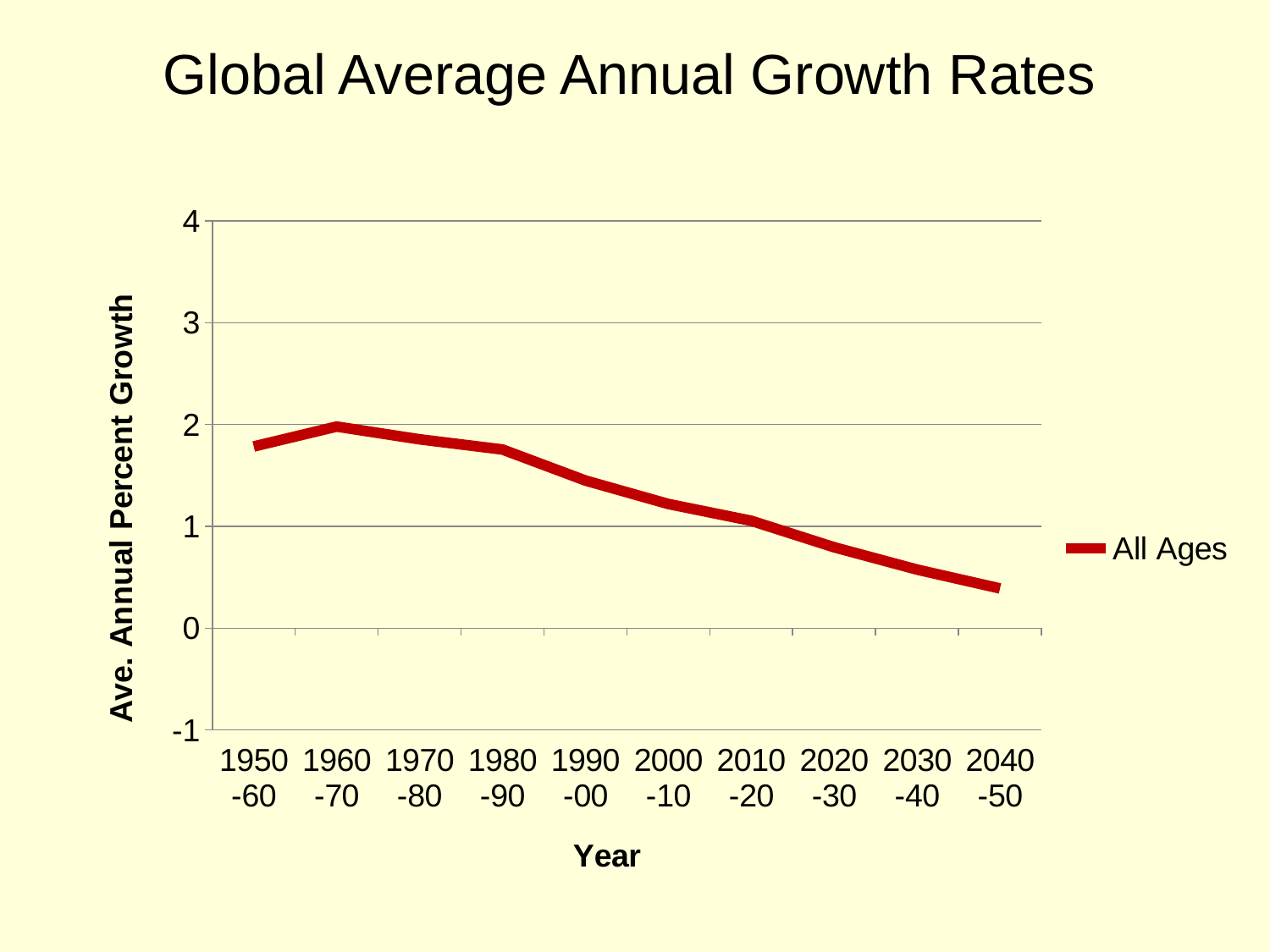
Is the value for 1950-60 greater or less than 2? less Do the values generally rise or fall from 1960-70 to 2040-50? fall How many series does the legend list? 1 Is the value for 2020-30 greater or less than 1? less How many time periods are plotted along the x axis? 10 What is the name of the series shown in the legend? All Ages Is the value for 1990-00 greater or less than 1? greater What is the title of the chart? Global Average Annual Growth Rates What kind of chart is shown on the slide? line chart Which period has the lowest average annual percent growth? 2040-50 Which period has the highest average annual percent growth? 1960-70 Which is larger, the value for 1950-60 or the value for 2040-50? 1950-60